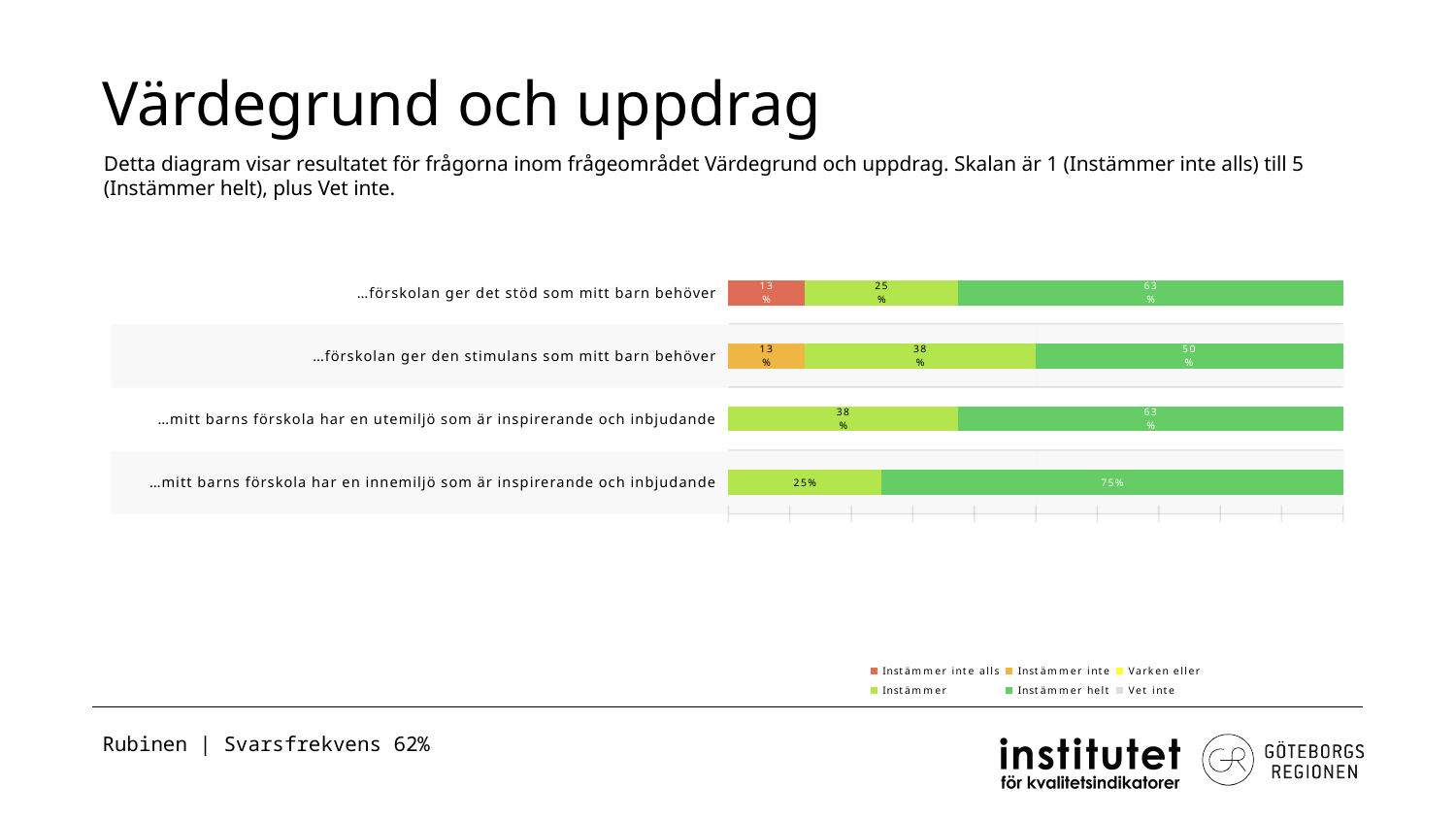
What is the total of the printed segments for the bar "…mitt barns förskola har en innemiljö som är inspirerande och inbjudande"? 100% What percentage answered "Instämmer" for "…förskolan ger den stimulans som mitt barn behöver"? 38% How many response categories does the legend list? 6 Which question has the lowest share of "Instämmer helt" responses? …förskolan ger den stimulans som mitt barn behöver What percentage of respondents answered "Instämmer helt" for "…mitt barns förskola har en innemiljö som är inspirerande och inbjudande"? 75% Which question has the highest share of "Instämmer helt" responses? …mitt barns förskola har en innemiljö som är inspirerande och inbjudande What percentage answered "Instämmer" for "…mitt barns förskola har en utemiljö som är inspirerande och inbjudande"? 38% How many questions (bars) are shown in the chart? 4 What type of chart is shown on the slide? Stacked horizontal bar chart What is the difference in percentage points between the "Instämmer helt" share for the innemiljö question (75%) and the stimulans question (50%)? 25 percentage points What percentage answered "Instämmer helt" for "…förskolan ger det stöd som mitt barn behöver"? 63% Which is larger: the "Instämmer" share for the utemiljö question or for the innemiljö question? The utemiljö question (38%)